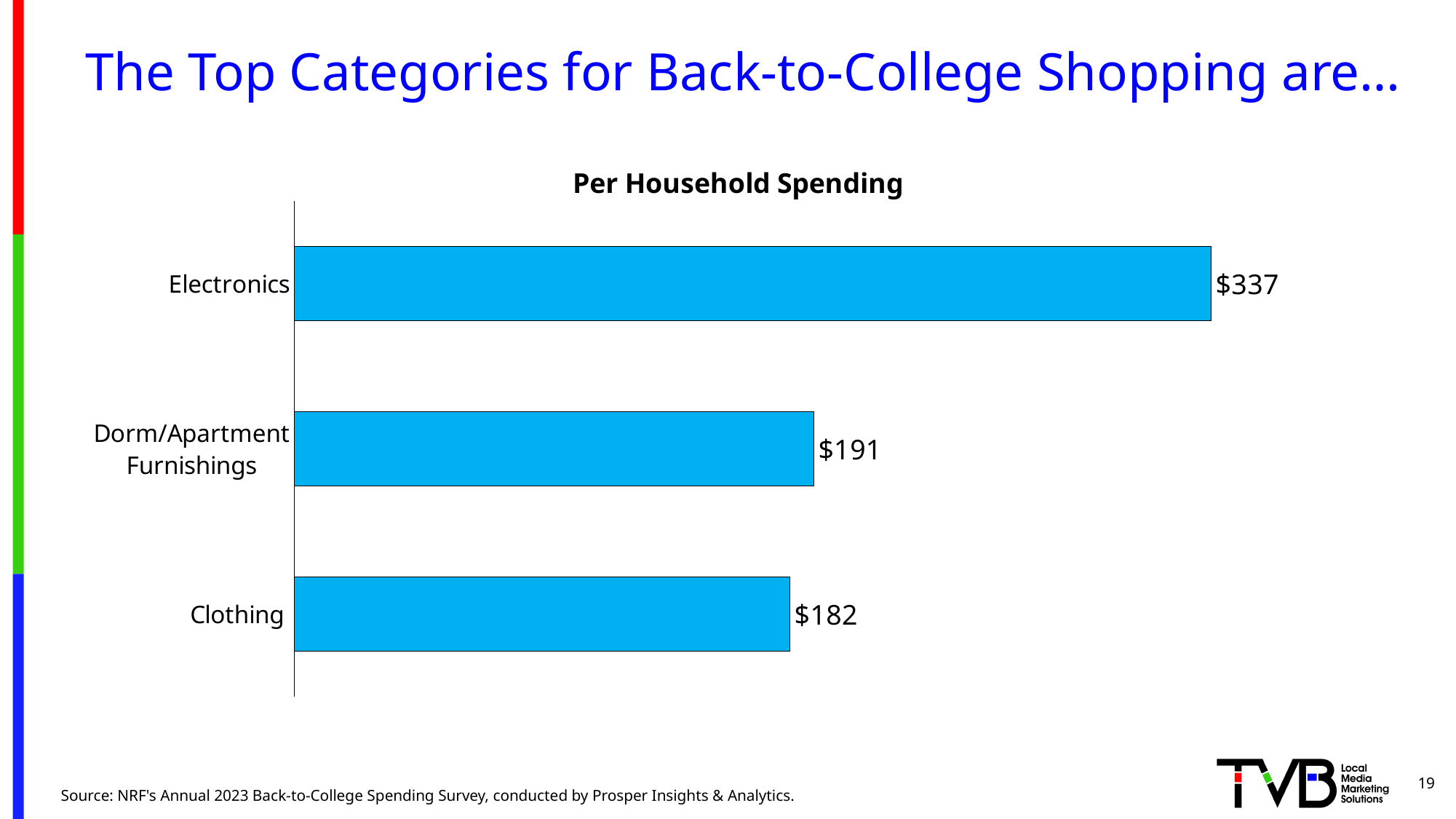
What is the per household spending on Dorm/Apartment Furnishings? $191 What is the per household spending on Electronics? $337 What is the difference in per household spending between Dorm/Apartment Furnishings and Clothing? $9 What is the title of the chart? Per Household Spending Which category has the lowest per household spending? Clothing How much more is spent per household on Electronics than on Clothing? $155 Which category has the highest per household spending? Electronics Which has higher per household spending, Electronics or Dorm/Apartment Furnishings? Electronics What is the per household spending on Clothing? $182 How much more is spent per household on Electronics than on Dorm/Apartment Furnishings? $146 What type of chart is shown on the slide? Bar chart How many categories are shown in the chart? 3